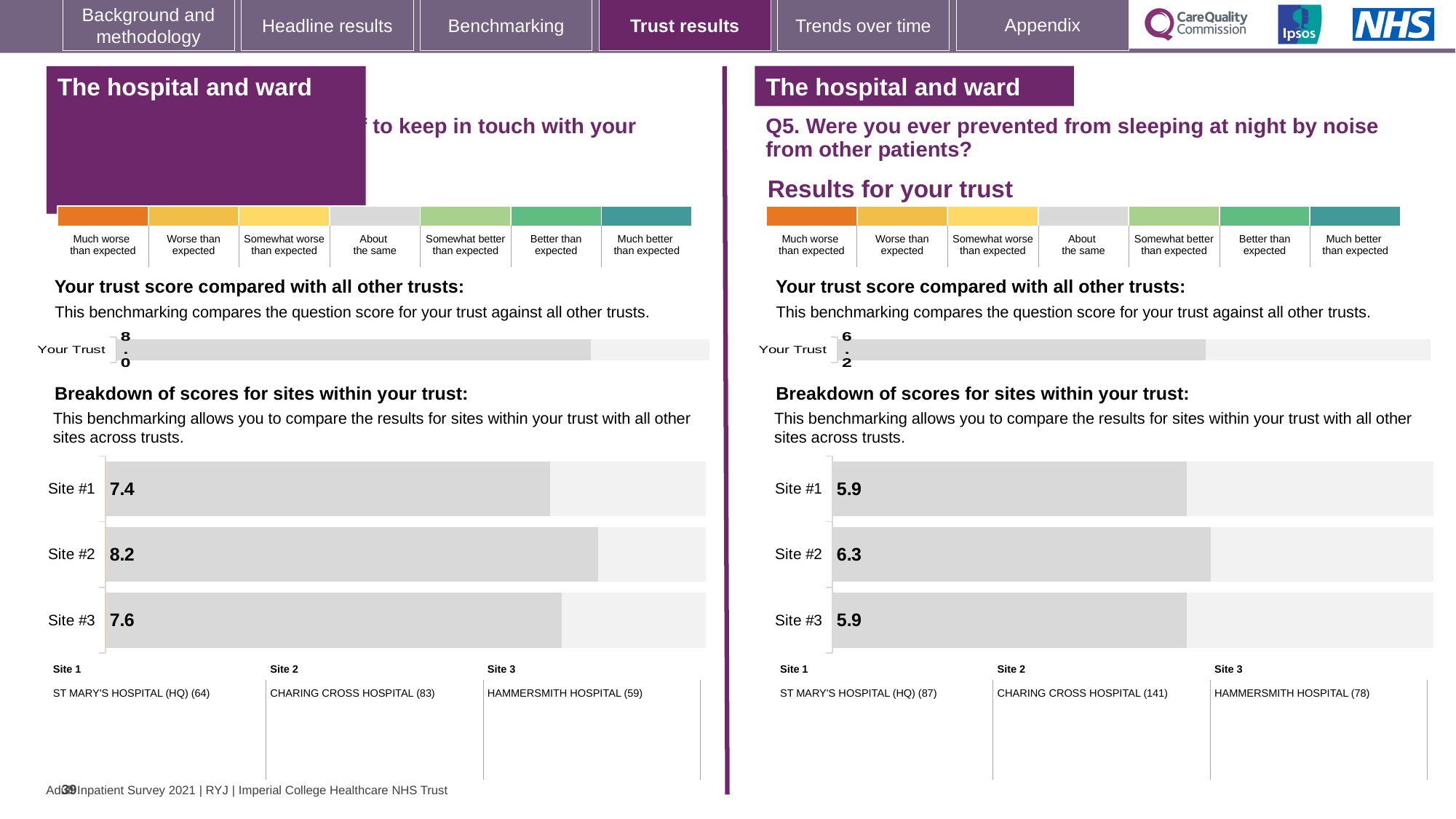
How many sites are shown in the site breakdown chart on the right-hand side (Q5)? 3 On the left-hand site breakdown chart, what is the difference between the scores for Site #2 and Site #1? 0.8 On the right-hand chart (Q5), what is the score for Site #1? 5.9 On the left-hand site breakdown chart, what is the score for Site #2? 8.2 On the left-hand site breakdown chart, which site has the highest score? Site #2 On the left-hand site breakdown chart, which site has the lowest score? Site #1 On the right-hand chart (Q5), what is the difference between the scores for Site #2 and Site #3? 0.4 On the right-hand chart (Q5), which site has the highest score? Site #2 On the right-hand chart (Q5), is the score for Site #1 or Site #2 larger? Site #2 On the right-hand chart (Q5, prevented from sleeping by noise from other patients), what is the score for Site #2? 6.3 On the left-hand site breakdown chart, what is the score for Site #3? 7.6 What kind of chart is used for the breakdown of scores for sites on the left-hand side? Bar chart